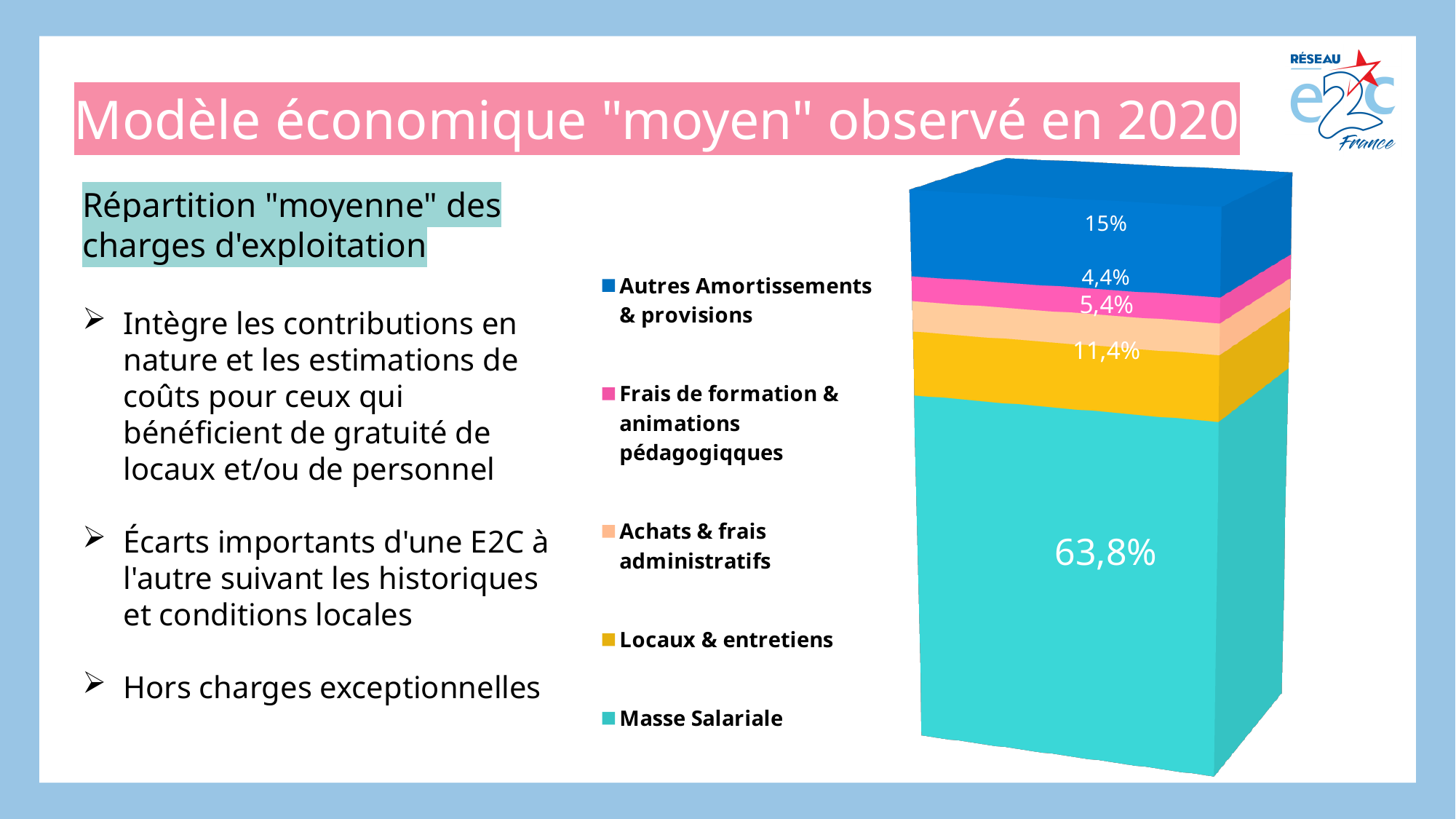
Which is larger: Achats & frais administratifs or Frais de formation & animations pédagogiques? Achats & frais administratifs What type of chart is used to show the breakdown of operating costs? Stacked bar chart How many categories does the legend of the chart list? 5 What share of operating costs does Masse Salariale represent in the stacked bar? 63,8% What percentage is shown for Achats & frais administratifs? 5,4% What percentage is shown for Locaux & entretiens? 11,4% What percentage is shown for Frais de formation & animations pédagogiques? 4,4% Which category has the largest share of the stacked bar? Masse Salariale Which category has the smallest share of the stacked bar? Frais de formation & animations pédagogiques What percentage is shown for Autres Amortissements & provisions? 15% What is the difference in percentage points between Autres Amortissements & provisions and Locaux & entretiens? 3,6 How many percentage points larger is Masse Salariale than Autres Amortissements & provisions? 48,8